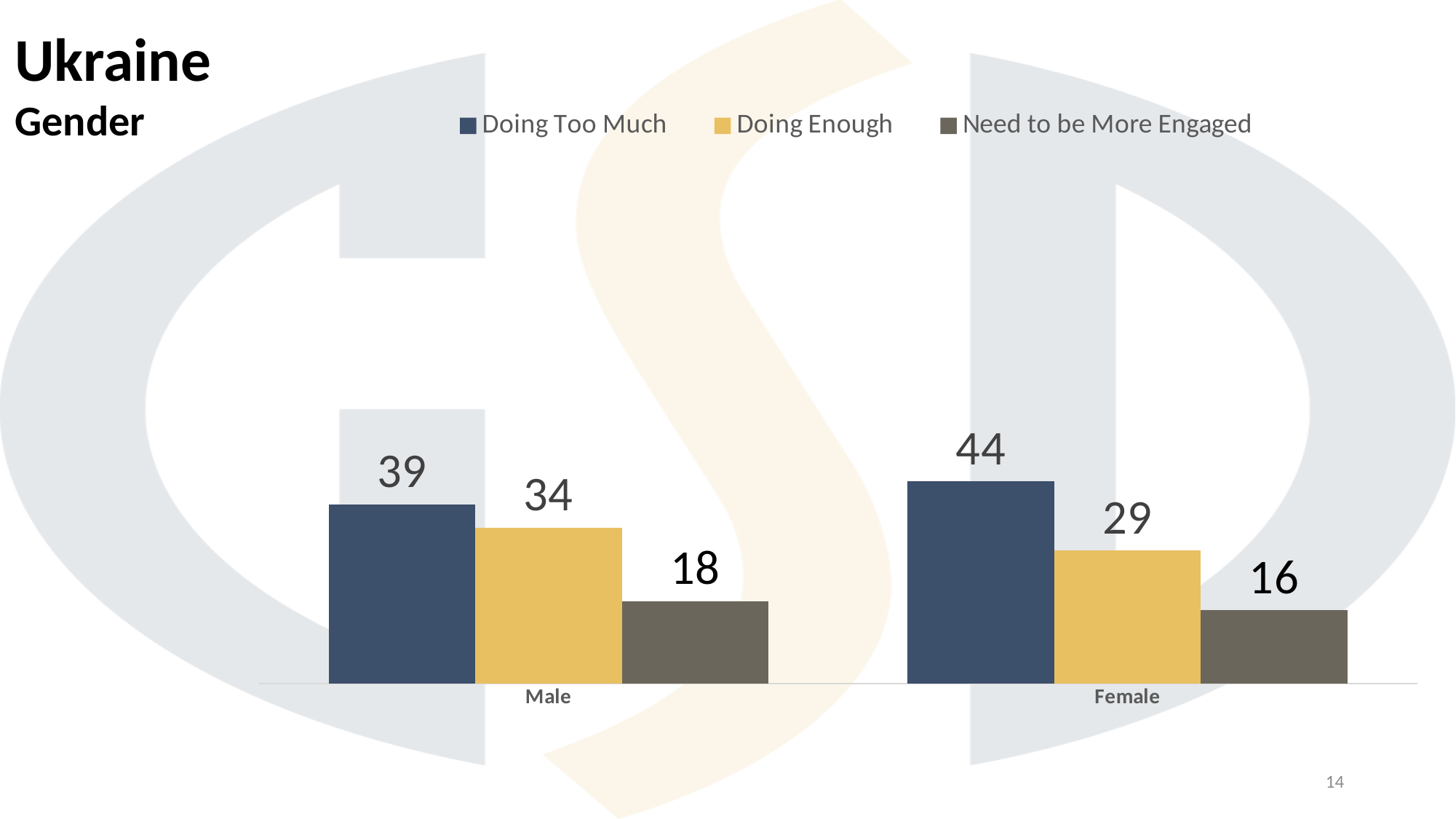
What is the difference between the "Doing Too Much" values for Female and Male respondents? 5 What is the value for "Doing Enough" among Female respondents? 29 What is the value for "Need to be More Engaged" among Male respondents? 18 What is the value for "Doing Too Much" among Male respondents? 39 Which series has the highest value for Female respondents? Doing Too Much Which colour represents the "Doing Enough" series in the legend? Yellow What is the difference between "Doing Enough" and "Need to be More Engaged" for Male respondents? 16 How many series does the legend list? 3 How many categories are shown on the x axis? 2 What kind of chart is shown on the slide? Bar chart Which is larger: "Doing Enough" for Male or "Doing Enough" for Female? Male Which series has the lowest value for Male respondents? Need to be More Engaged